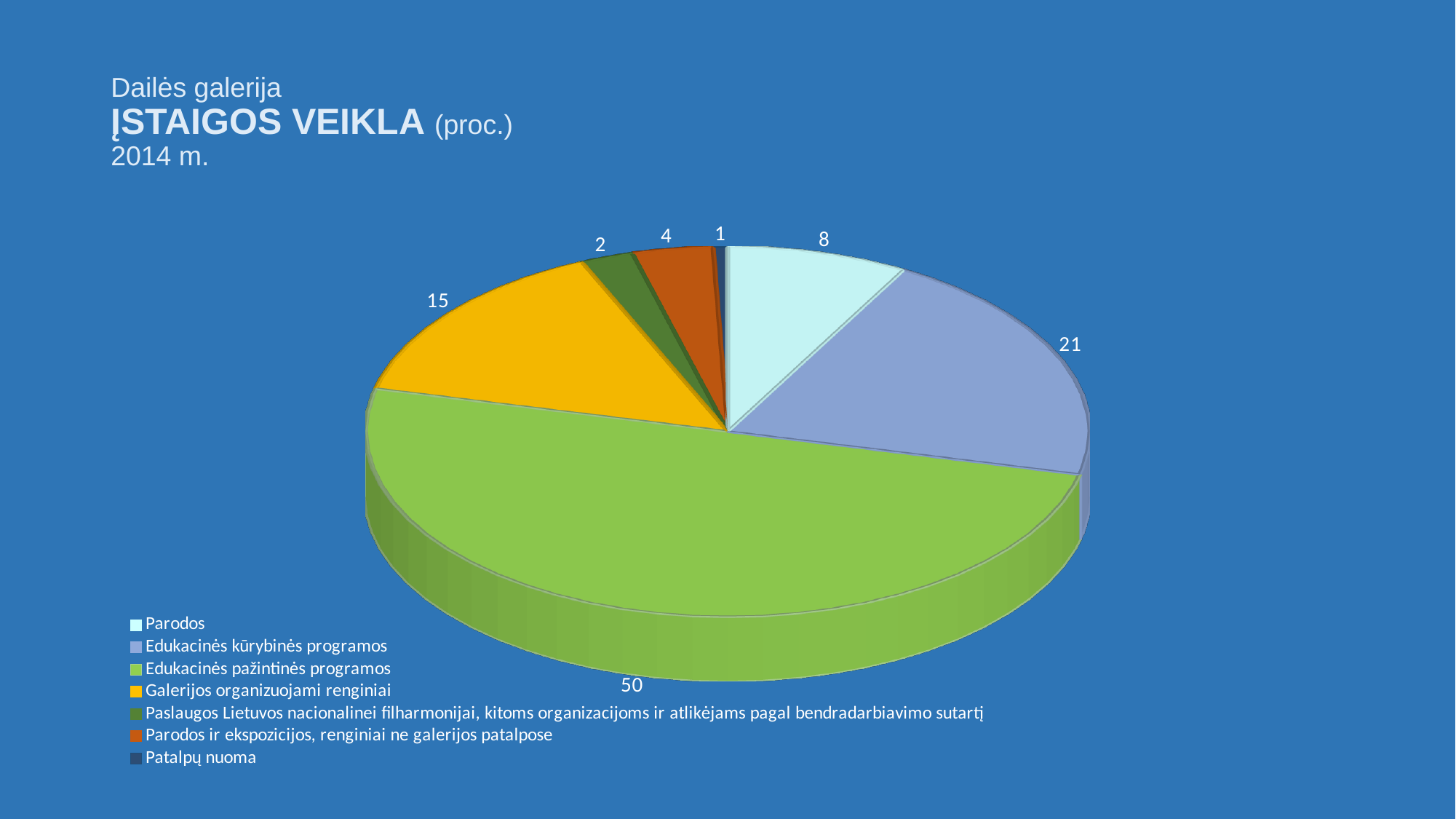
Which category has the smallest slice of the pie? Patalpų nuoma What is the value for Patalpų nuoma? 1 What is the value for Parodos? 8 Which is larger, the value for Galerijos organizuojami renginiai or the value for Edukacinės kūrybinės programos? Edukacinės kūrybinės programos Which year does the chart title refer to? 2014 m. Which category has the largest slice of the pie? Edukacinės pažintinės programos What type of chart is shown on the slide? pie chart What is the value for Galerijos organizuojami renginiai? 15 What is the value for Parodos ir ekspozicijos, renginiai ne galerijos patalpose? 4 How many categories does the pie chart have? 7 What is the value for Edukacinės pažintinės programos? 50 What is the difference between the values for Edukacinės kūrybinės programos and Parodos? 13